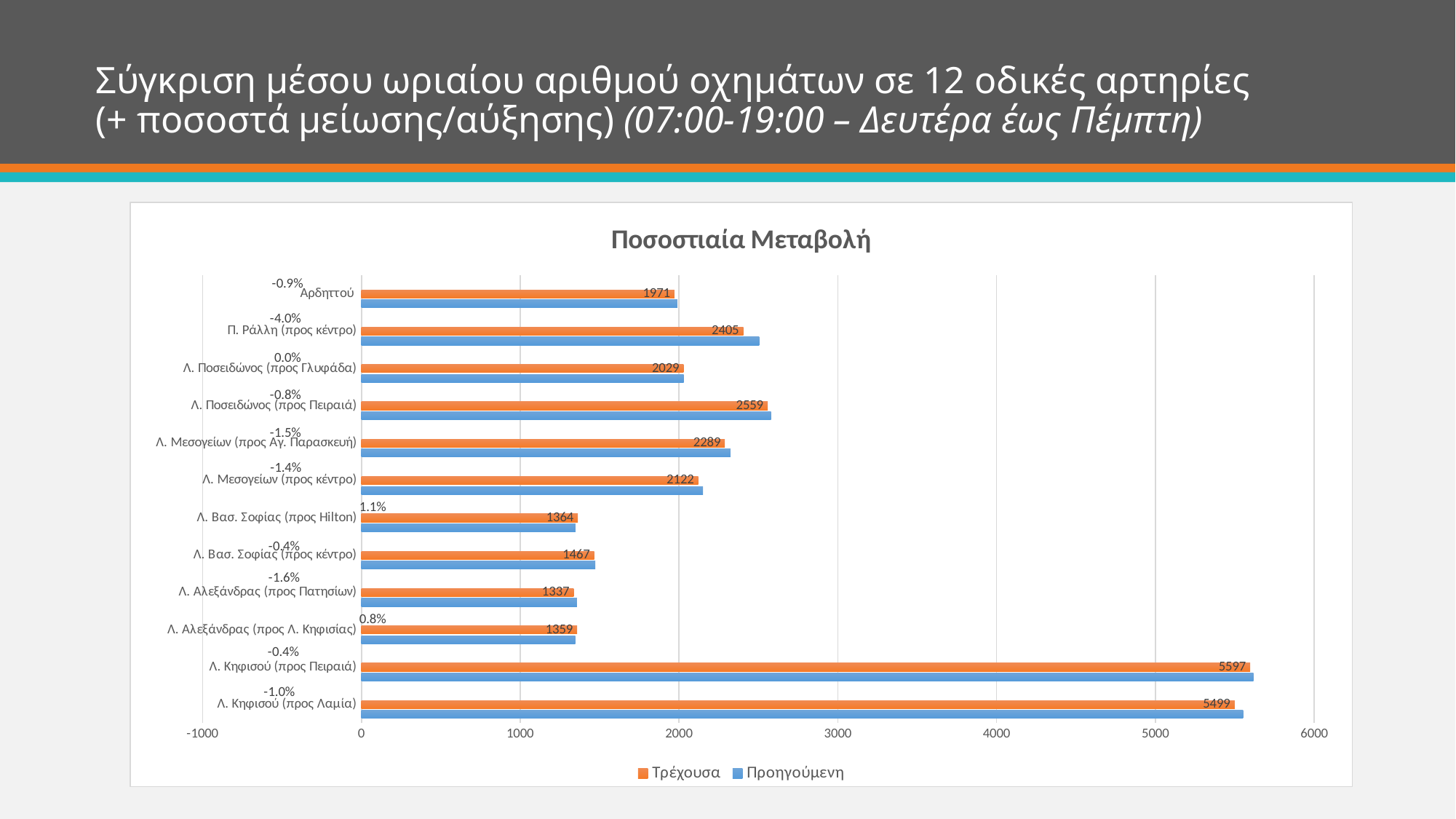
What is the Τρέχουσα value for Π. Ράλλη (προς κέντρο)? 2405 What is the Τρέχουσα value for Αρδηττού? 1971 How many series does the legend list? 2 What is the difference between the Τρέχουσα values for Λ. Κηφισού (προς Πειραιά) and Λ. Κηφισού (προς Λαμία)? 98 What kind of chart is shown? bar chart What percentage change is shown next to Π. Ράλλη (προς κέντρο)? -4.0% How many roads are shown on the chart? 12 Which road has the lowest Τρέχουσα value? Λ. Αλεξάνδρας (προς Πατησίων) Which road has the highest Τρέχουσα value? Λ. Κηφισού (προς Πειραιά) Is the Προηγούμενη value for Π. Ράλλη (προς κέντρο) greater or less than 2000? greater Which has the larger Τρέχουσα value: Λ. Μεσογείων (προς Αγ. Παρασκευή) or Λ. Μεσογείων (προς κέντρο)? Λ. Μεσογείων (προς Αγ. Παρασκευή) What is the Τρέχουσα value for Λ. Κηφισού (προς Λαμία)? 5499